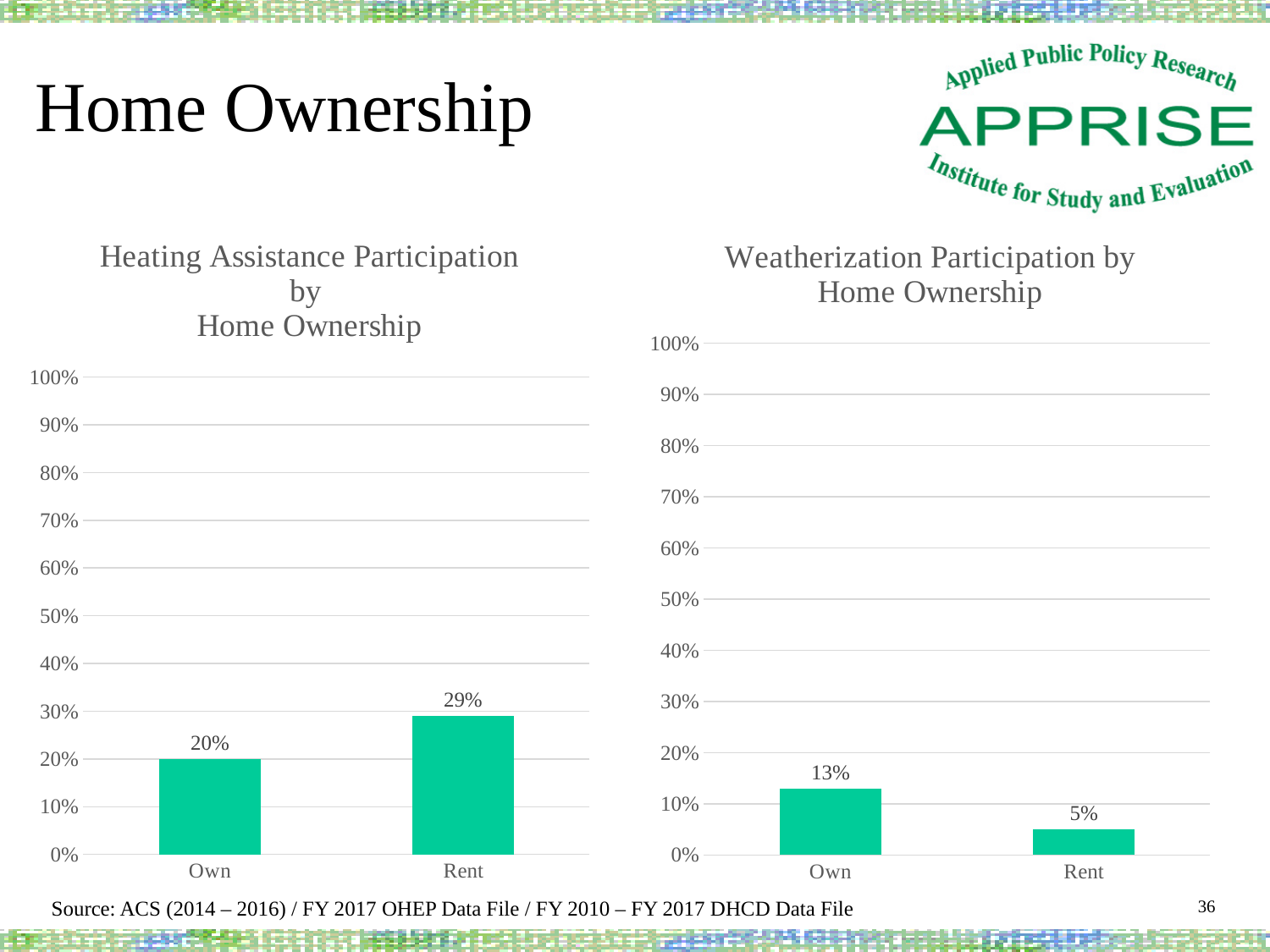
What kind of chart is the Heating Assistance Participation by Home Ownership chart? Bar chart In the Heating Assistance Participation by Home Ownership chart, what is the value for Rent? 29% In the Weatherization Participation by Home Ownership chart, which category has the lowest value? Rent In the Heating Assistance Participation by Home Ownership chart, which category has the highest value? Rent In the Weatherization Participation by Home Ownership chart, what is the value for Own? 13% In the Heating Assistance Participation by Home Ownership chart, is the value for Rent greater or less than 30%? less In the Weatherization Participation by Home Ownership chart, what is the value for Rent? 5% In the Heating Assistance Participation by Home Ownership chart, what is the difference between the Rent and Own values? 9% How many categories are shown in the Weatherization Participation by Home Ownership chart? 2 In the Heating Assistance Participation by Home Ownership chart, what is the value for Own? 20% In the Weatherization Participation by Home Ownership chart, what is the difference between the Own and Rent values? 8% In the Weatherization Participation by Home Ownership chart, which is larger, the value for Own or the value for Rent? Own